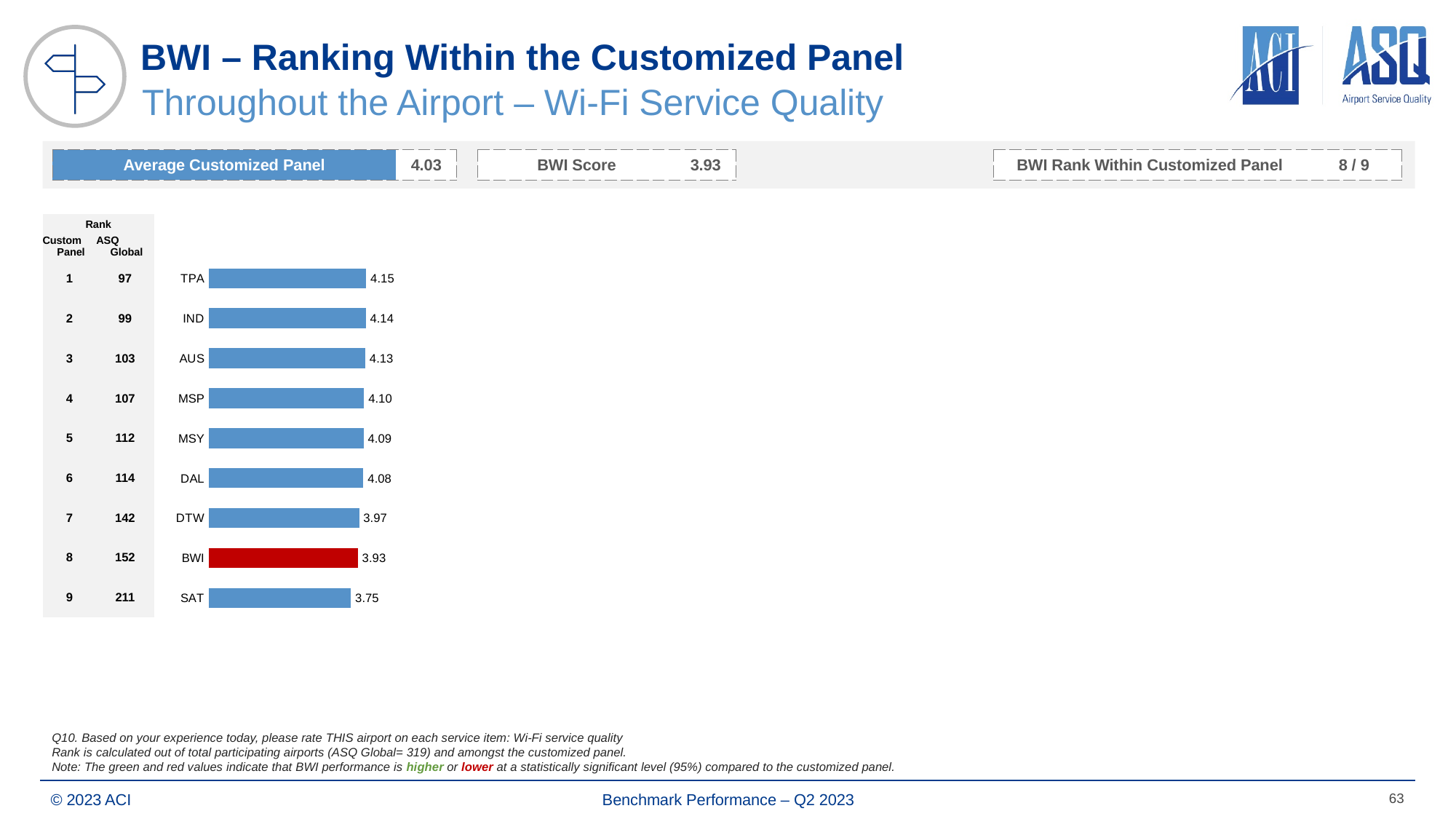
Which has a higher score, MSP or DAL? MSP Do the scores increase or decrease going down the chart from TPA to SAT? Decrease What is the Wi-Fi service quality score for TPA? 4.15 What is the difference between the TPA score and the SAT score? 0.40 Which airport has the lowest score in the chart? SAT What is the score shown for BWI in the bar chart? 3.93 Which airport's bar is coloured red in the chart? BWI How many airports are shown in the bar chart? 9 What is the score for DTW? 3.97 What is the difference between the DTW score and the BWI score? 0.04 What type of chart is used to show the airport scores? Bar chart Which airport has the highest score in the chart? TPA